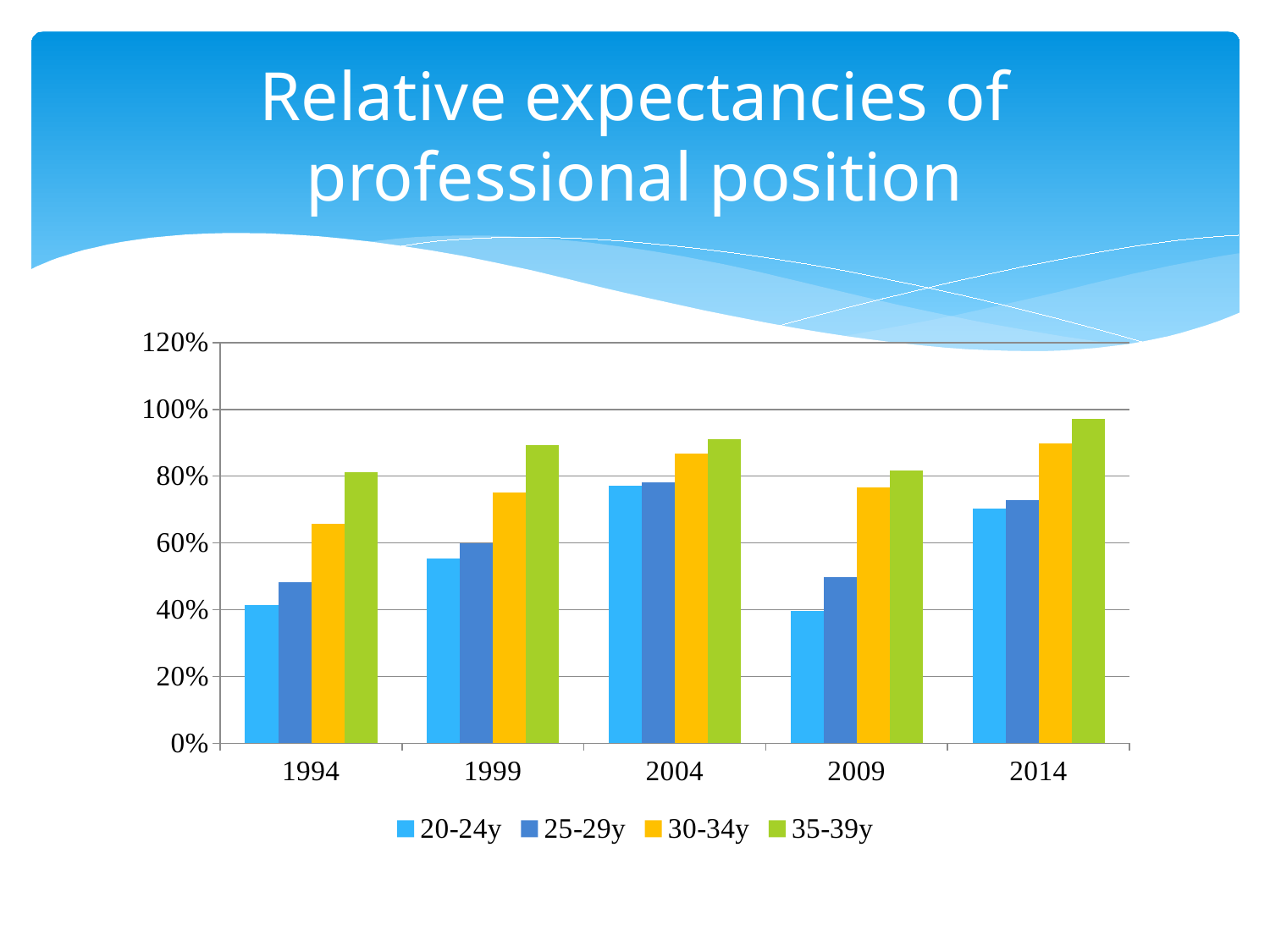
Which age group has the lowest value in 2009? 20-24y In which year is the 35-39y bar the highest? 2014 Is the value for 20-24y in 2009 greater or less than 60%? less Is the value for 30-34y in 1994 greater or less than 60%? greater Is the value for 35-39y in 2014 greater or less than 80%? greater Which is larger: the 30-34y value in 2004 or in 2009? 2004 What kind of chart is shown on the slide? bar chart Does the 35-39y value rise or fall from 2009 to 2014? rise What is the title of the slide containing the chart? Relative expectancies of professional position How many series does the legend list? 4 How many years are shown on the x axis of the chart? 5